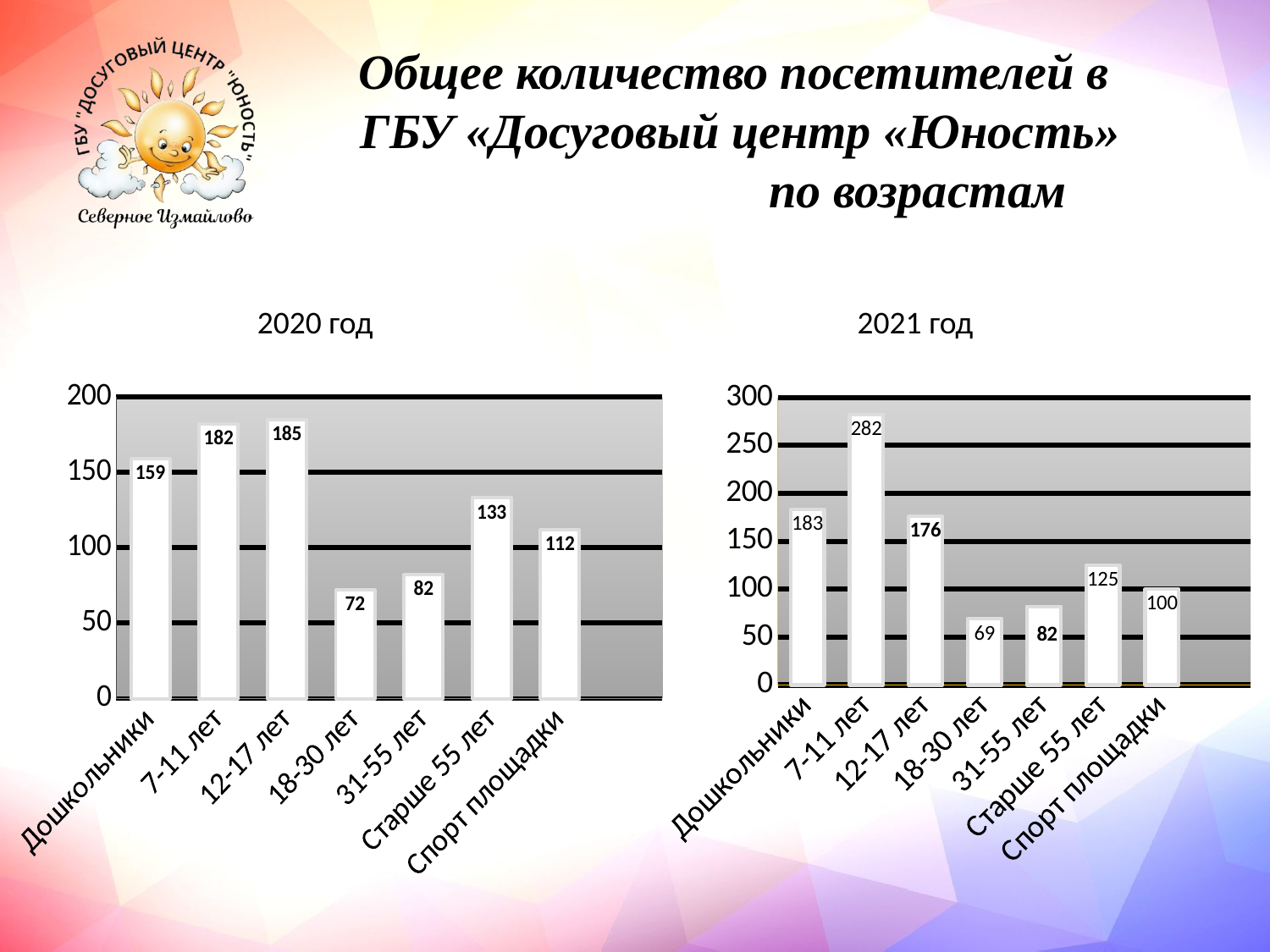
In the 2021 год chart, what is the value for Старше 55 лет? 125 In the 2021 год chart, is the value for 12-17 лет greater or less than 150? greater In the 2020 год chart, which is larger: the value for Дошкольники or the value for Старше 55 лет? Дошкольники In the 2020 год chart, what is the value for 31-55 лет? 82 In the 2021 год chart, which category has the highest value? 7-11 лет In the 2020 год chart, which category has the highest value? 12-17 лет How many categories are shown in the 2020 год chart? 7 What type of chart is the 2021 год chart? bar chart In the 2021 год chart, what is the difference between the values for 7-11 лет and Дошкольники? 99 In the 2020 год chart, what is the value for 7-11 лет? 182 In the 2021 год chart, which category has the lowest value? 18-30 лет In the 2020 год chart, what is the difference between the values for Старше 55 лет and Спорт площадки? 21